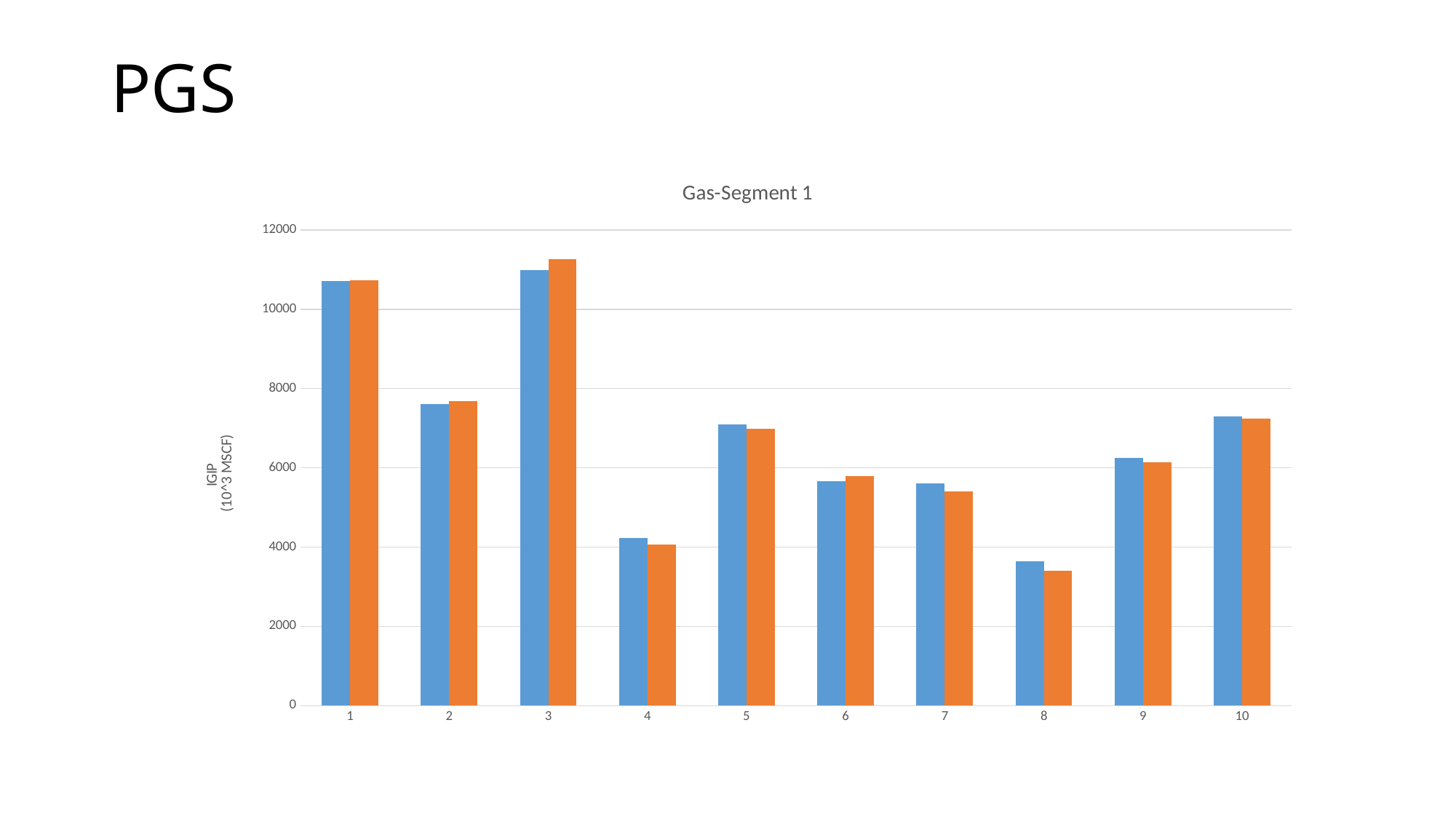
What is the title of the chart? Gas-Segment 1 What type of chart is shown on the slide? bar chart Is the orange bar for category 8 greater or less than 4000? less What is the label on the vertical axis of the chart? IGIP (10^3 MSCF) Which has the larger blue bar, category 1 or category 4? 1 Which category has the highest blue bar in the chart? 3 Which category has the lowest orange bar in the chart? 8 Is the blue bar for category 3 greater or less than 10000? greater Is the orange bar for category 5 greater or less than 6000? greater How many categories are shown along the x axis of the chart? 10 Which has the larger orange bar, category 5 or category 6? 5